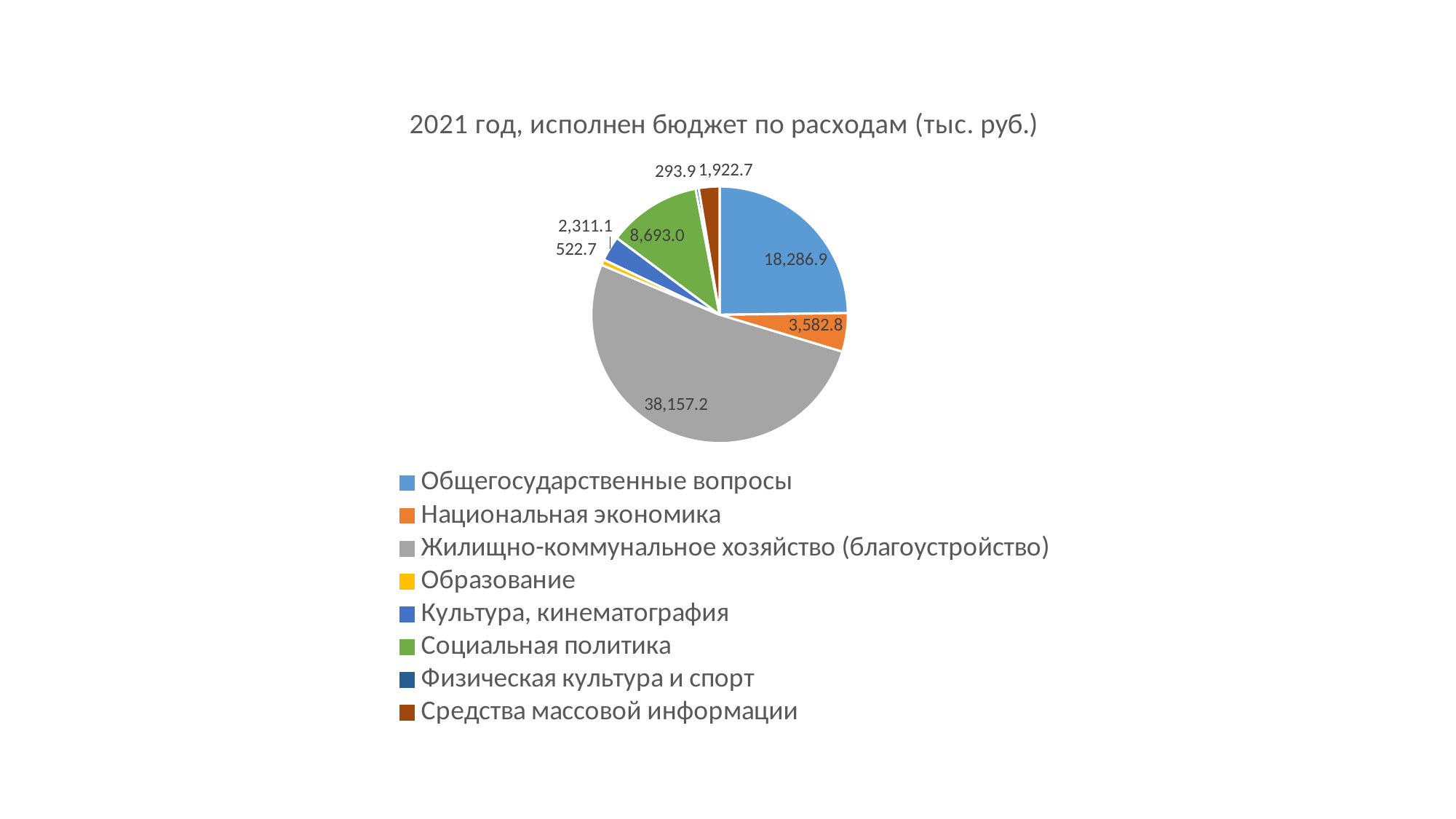
What is the value for Жилищно-коммунальное хозяйство (благоустройство)? 38,157.2 What is the difference between the values for Социальная политика and Культура, кинематография? 6,381.9 Which category has the largest slice of the pie? Жилищно-коммунальное хозяйство (благоустройство) What is the difference between the values for Общегосударственные вопросы and Национальная экономика? 14,704.1 What is the title of the chart? 2021 год, исполнен бюджет по расходам (тыс. руб.) What is the value for Общегосударственные вопросы? 18,286.9 How many categories does the legend list? 8 What type of chart is shown on the slide? pie chart What is the value for Социальная политика? 8,693.0 Which is larger, the value for Средства массовой информации or the value for Образование? Средства массовой информации What is the value for Физическая культура и спорт? 293.9 Which category has the smallest slice of the pie? Физическая культура и спорт